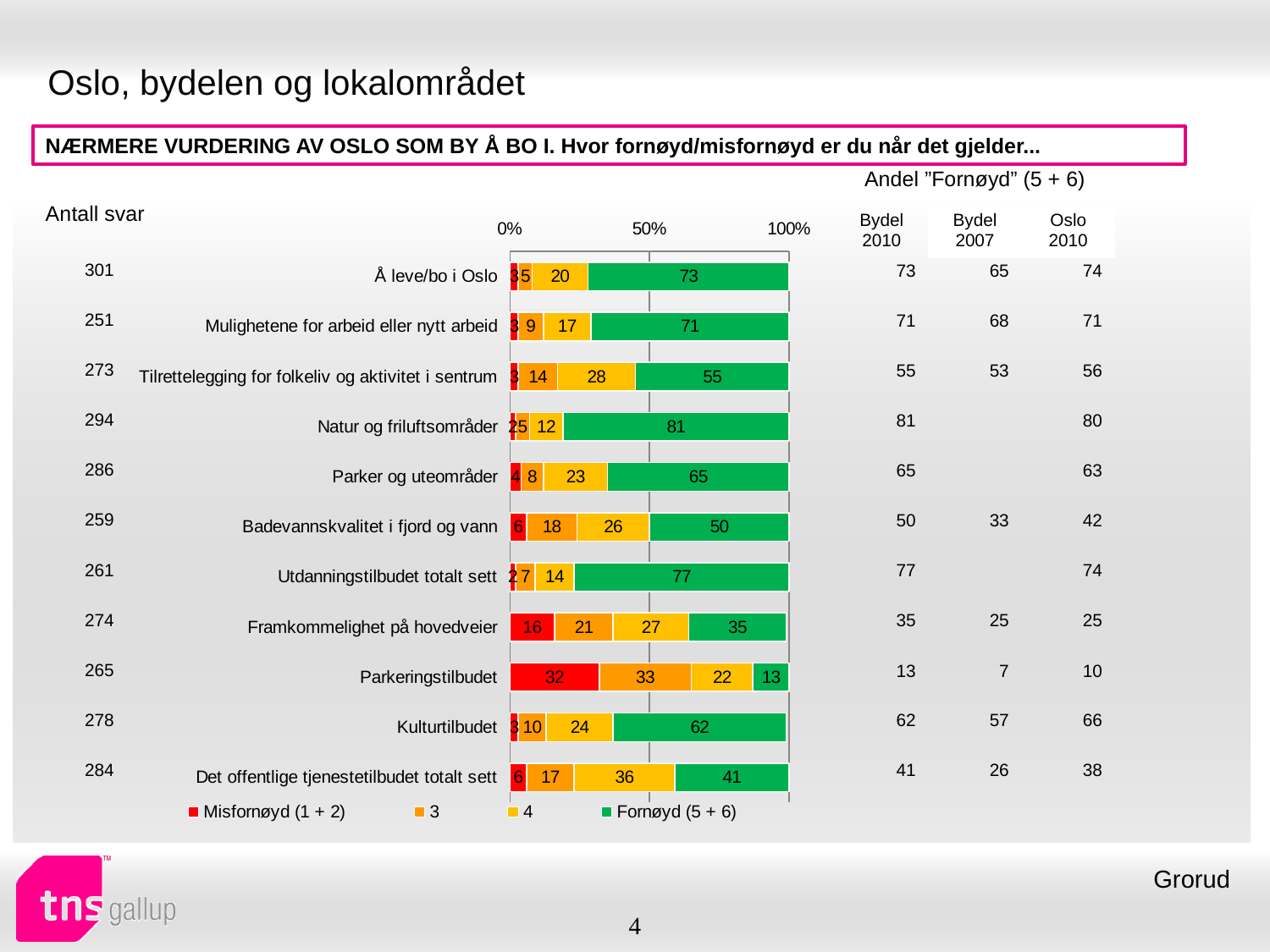
How many series does the legend list? 4 Which has a larger Fornøyd (5 + 6) value, Badevannskvalitet i fjord og vann or Framkommelighet på hovedveier? Badevannskvalitet i fjord og vann What is the difference between the Fornøyd (5 + 6) values for Å leve/bo i Oslo and Kulturtilbudet? 11 What is the value of series 3 for Framkommelighet på hovedveier? 21 What is the Fornøyd (5 + 6) value for Natur og friluftsområder? 81 What is the Misfornøyd (1 + 2) value for Parkeringstilbudet? 32 What kind of chart is shown on the slide? Stacked bar chart Which category has the lowest Fornøyd (5 + 6) value? Parkeringstilbudet How many categories are shown in the bar chart? 11 What is the value of series 4 for Det offentlige tjenestetilbudet totalt sett? 36 Which category has the highest Fornøyd (5 + 6) value? Natur og friluftsområder Is the Fornøyd (5 + 6) value for Utdanningstilbudet totalt sett greater or less than 50? greater